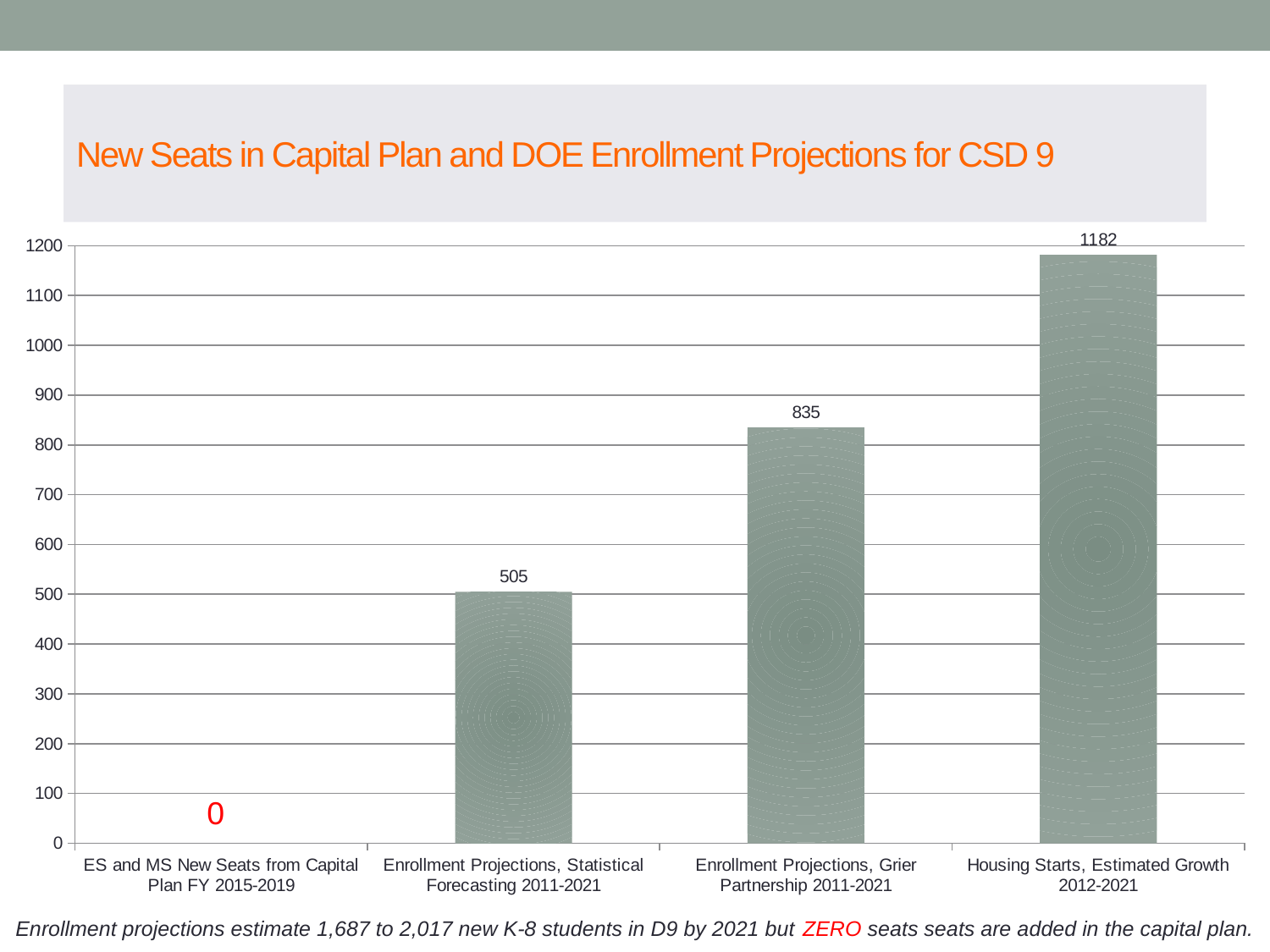
What is the title of the chart? New Seats in Capital Plan and DOE Enrollment Projections for CSD 9 Which category has the highest value? Housing Starts, Estimated Growth 2012-2021 What is the value for Enrollment Projections, Statistical Forecasting 2011-2021? 505 Which is larger, the value for Enrollment Projections, Statistical Forecasting 2011-2021 or the value for Enrollment Projections, Grier Partnership 2011-2021? Enrollment Projections, Grier Partnership 2011-2021 How many categories are shown on the x axis? 4 What kind of chart is shown on the slide? bar chart Which category has the lowest value? ES and MS New Seats from Capital Plan FY 2015-2019 What is the difference between the values for Housing Starts, Estimated Growth 2012-2021 and Enrollment Projections, Grier Partnership 2011-2021? 347 What is the difference between the values for Enrollment Projections, Grier Partnership 2011-2021 and Enrollment Projections, Statistical Forecasting 2011-2021? 330 What is the value for Housing Starts, Estimated Growth 2012-2021? 1182 What is the value for ES and MS New Seats from Capital Plan FY 2015-2019? 0 What is the value for Enrollment Projections, Grier Partnership 2011-2021? 835